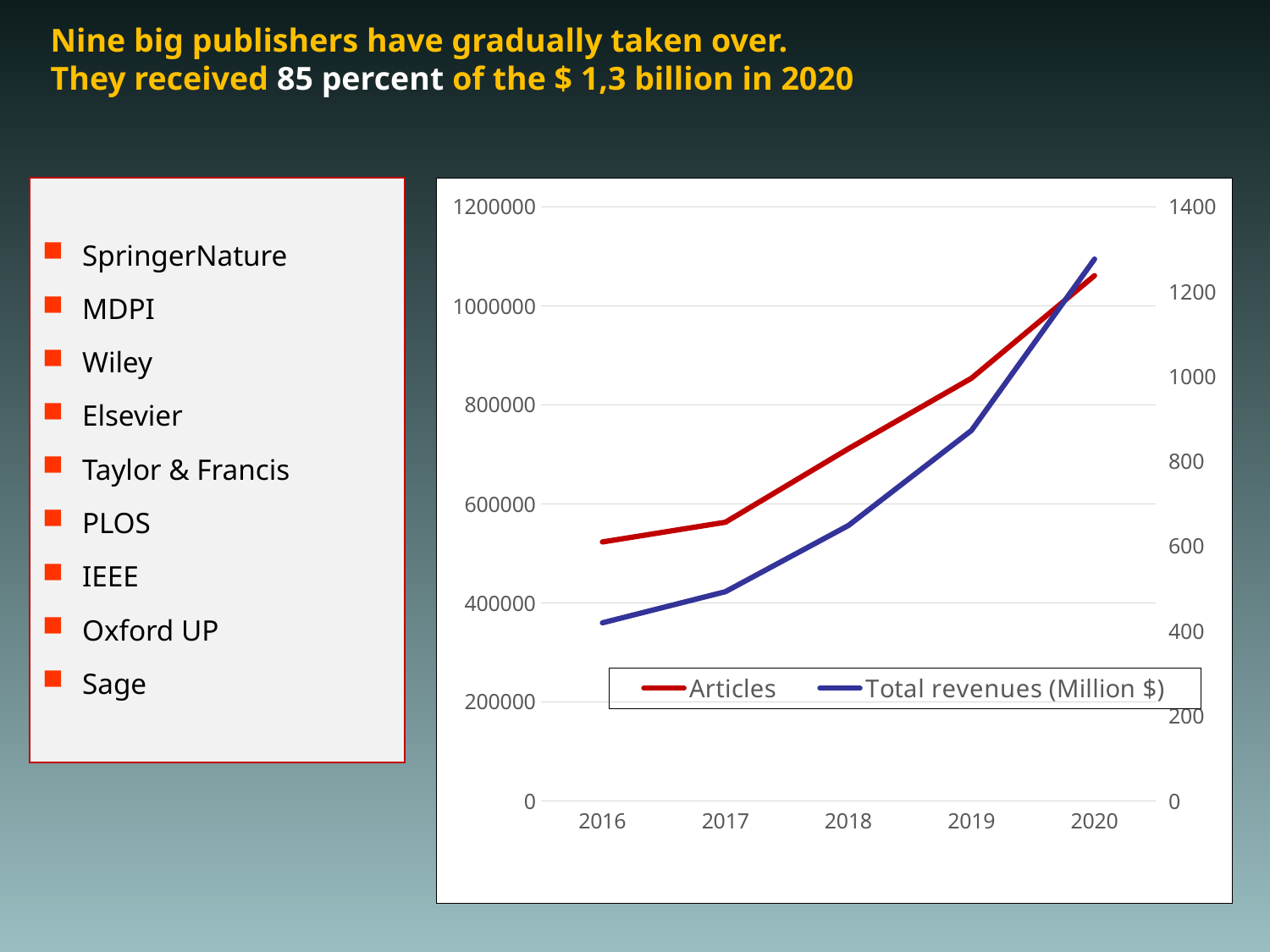
How many series does the chart's legend list? 2 How many years are plotted along the x axis of the chart? 5 What colour is the Articles line in the chart? red In which year is the Total revenues (Million $) value lowest? 2016 Is the Articles value for 2020 greater or less than 1000000? greater What kind of chart is shown on the slide? line chart Is the Total revenues (Million $) value for 2020 greater or less than 1200? greater In which year is the Articles value highest? 2020 Do the Total revenues (Million $) values rise or fall from 2016 to 2020? rise Is the Total revenues (Million $) value for 2018 greater or less than 800? less Do the Articles values rise or fall from 2016 to 2020? rise